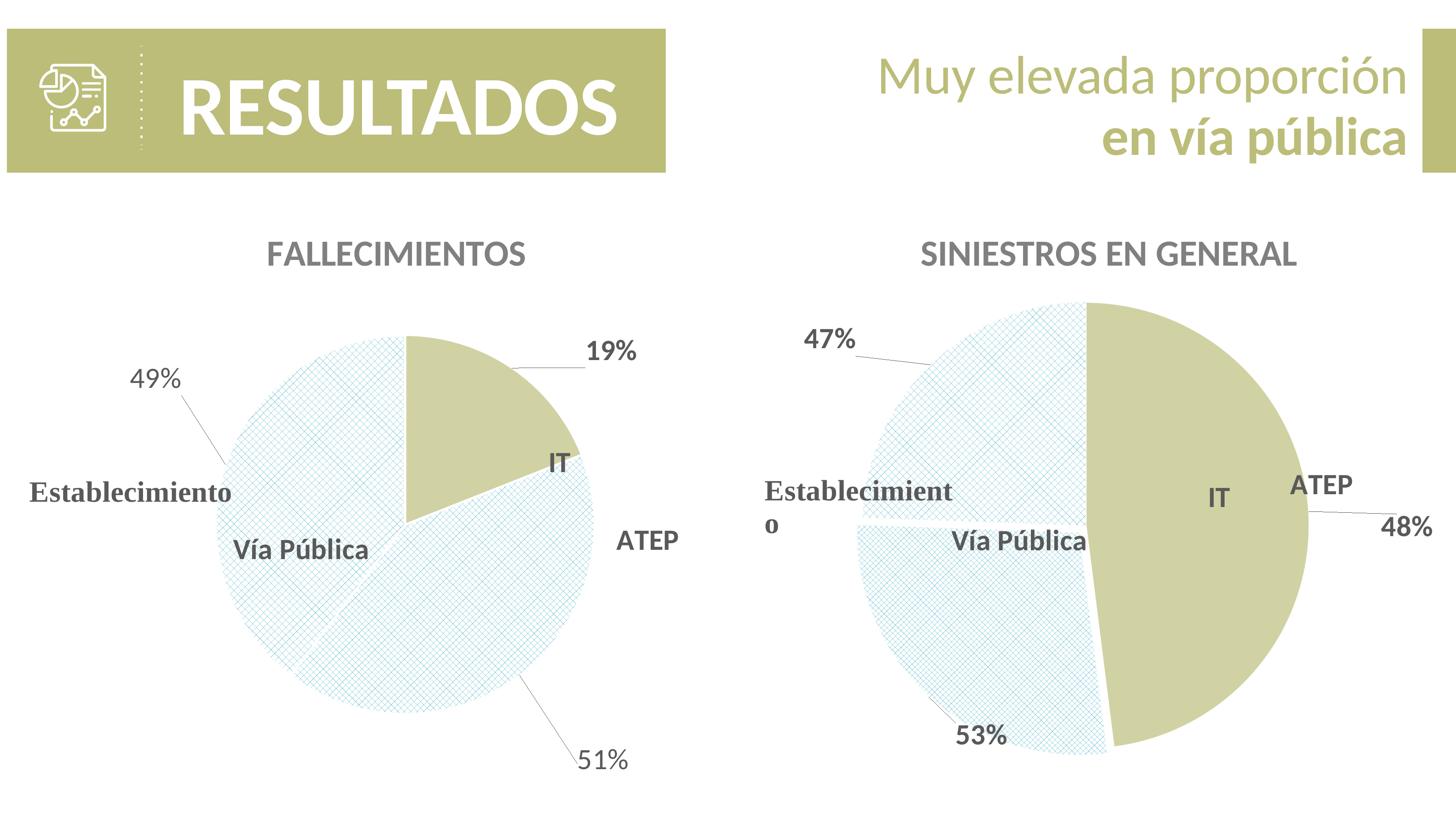
In the FALLECIMIENTOS chart, is the IT slice greater or less than 50% of the pie? less How many charts are shown on the slide? 2 Which chart shows a larger percentage for the IT slice, FALLECIMIENTOS or SINIESTROS EN GENERAL? SINIESTROS EN GENERAL What kind of chart is the SINIESTROS EN GENERAL chart? Pie chart In the FALLECIMIENTOS chart, what percentage is labelled on the IT slice? 19% What is the difference in percentage points between the IT slice in SINIESTROS EN GENERAL (48%) and the IT slice in FALLECIMIENTOS (19%)? 29 percentage points In the SINIESTROS EN GENERAL chart, which percentage label is placed at the top left near the Establecimiento label? 47% What is the title of the chart on the right of the slide? SINIESTROS EN GENERAL What kind of chart is the FALLECIMIENTOS chart? Pie chart What is the title of the chart on the left of the slide? FALLECIMIENTOS In the SINIESTROS EN GENERAL chart, what percentage is labelled on the IT slice? 48% In the SINIESTROS EN GENERAL chart, which percentage label is placed next to the Vía Pública label at the bottom of the pie? 53%